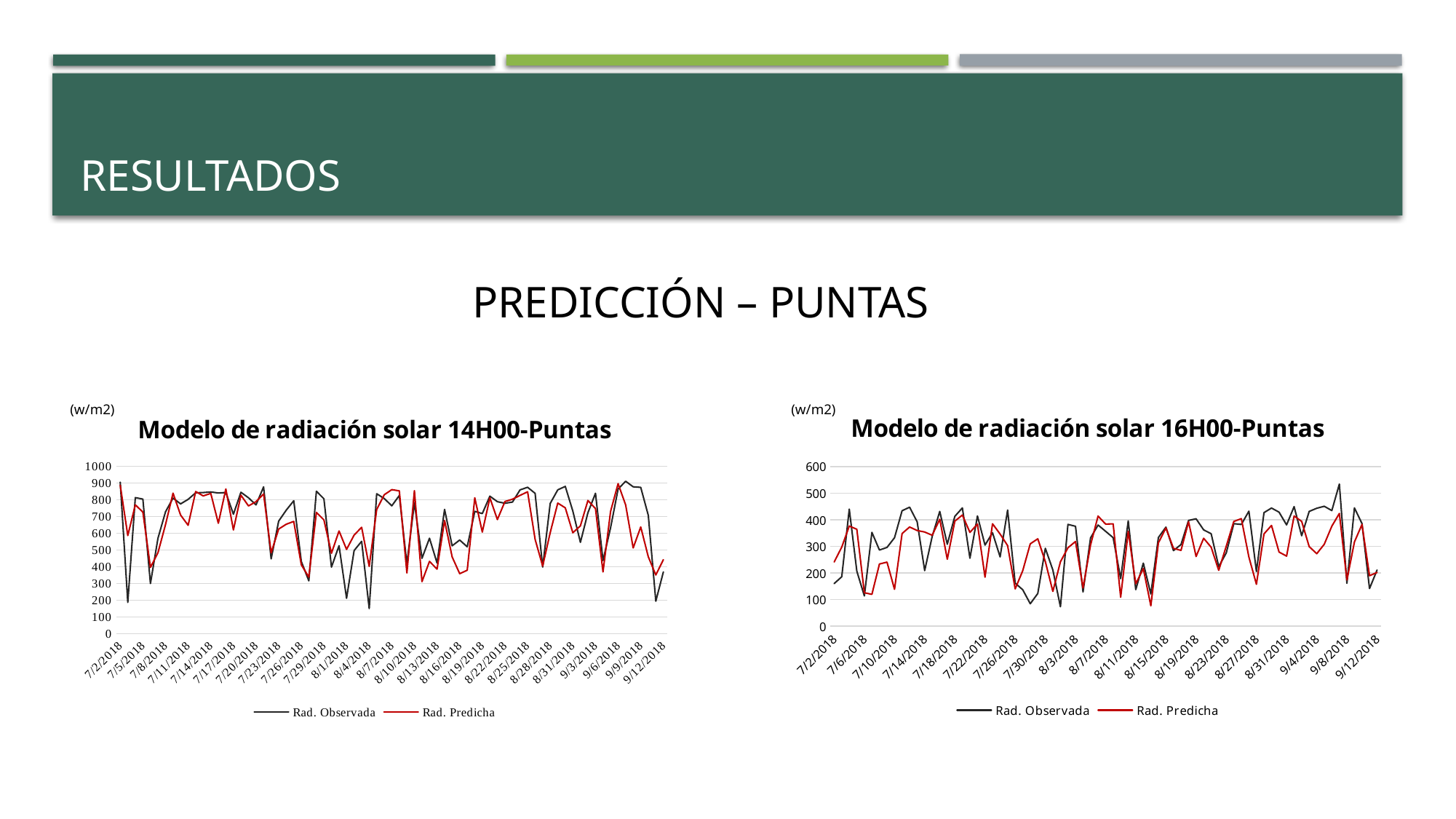
What kind of chart is the 'Modelo de radiación solar 14H00-Puntas' chart? line chart What unit is shown above the y axis of the 'Modelo de radiación solar 14H00-Puntas' chart? (w/m2) In the 'Modelo de radiación solar 16H00-Puntas' chart, is the Rad. Predicha value on 7/2/2018 greater or less than 200? greater In the 'Modelo de radiación solar 16H00-Puntas' chart, is the Rad. Observada value on 7/2/2018 greater or less than 200? less What kind of chart is the 'Modelo de radiación solar 16H00-Puntas' chart? line chart In the 'Modelo de radiación solar 14H00-Puntas' chart, is the Rad. Observada value on 7/2/2018 greater or less than 800? greater How many series does the legend of the 'Modelo de radiación solar 16H00-Puntas' chart list? 2 In the 'Modelo de radiación solar 16H00-Puntas' chart, which series is drawn in red? Rad. Predicha How many series does the legend of the 'Modelo de radiación solar 14H00-Puntas' chart list? 2